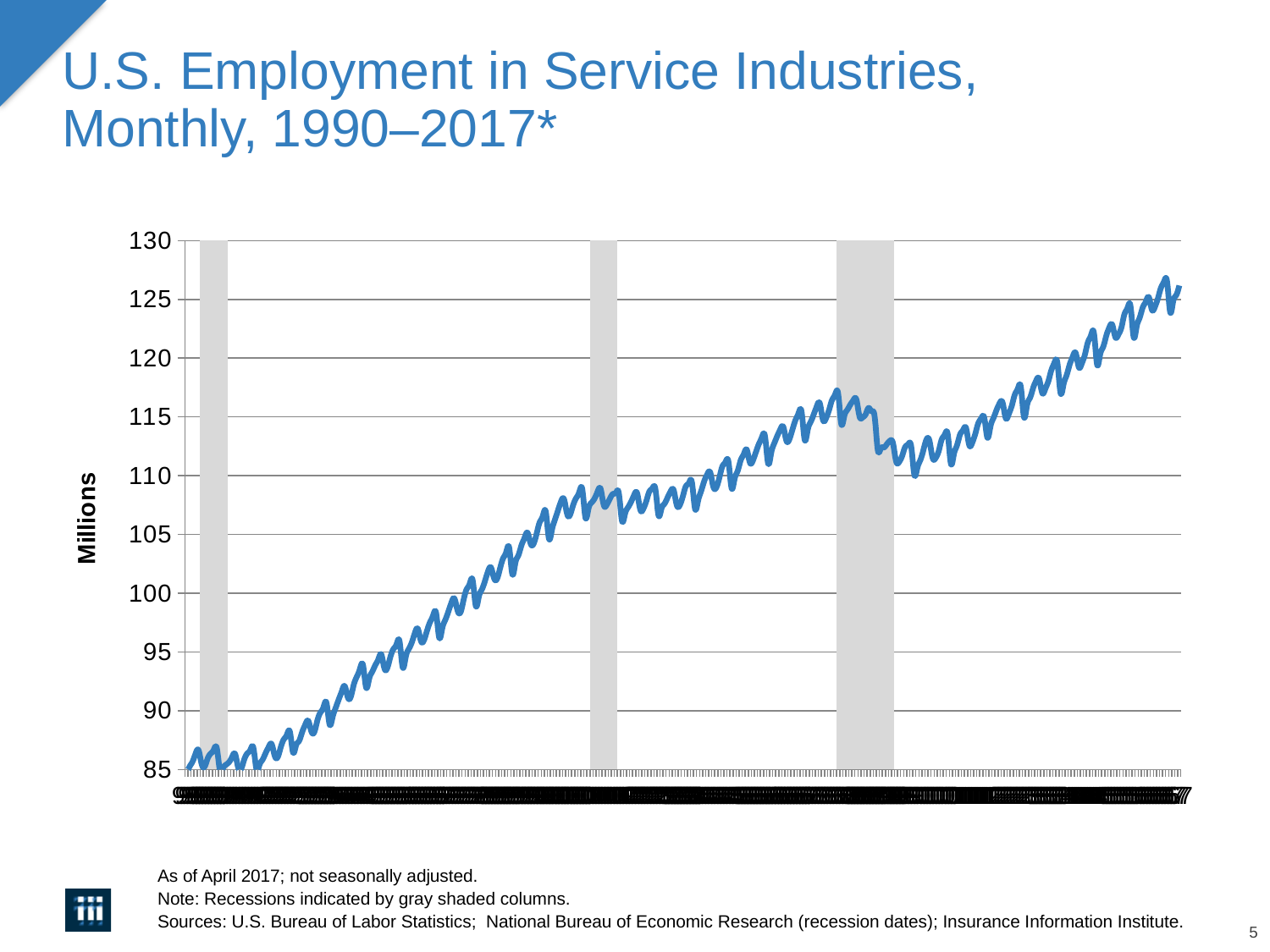
Is the highest value reached by the line greater or less than 130? less Is the lowest point reached just after the third gray shaded column greater or less than 115? less How many gray shaded columns (recessions) are shown on the chart? 3 Where along the series does the line reach its lowest value, at the left end or the right end? left end Where along the series does the line reach its highest value, at the left end or the right end? right end Is the value at the left end of the series (the earliest point) greater or less than 90? less Do the values generally rise or fall from left to right along the x axis? rise What kind of chart is shown on the slide? line chart What is the label on the vertical axis? Millions